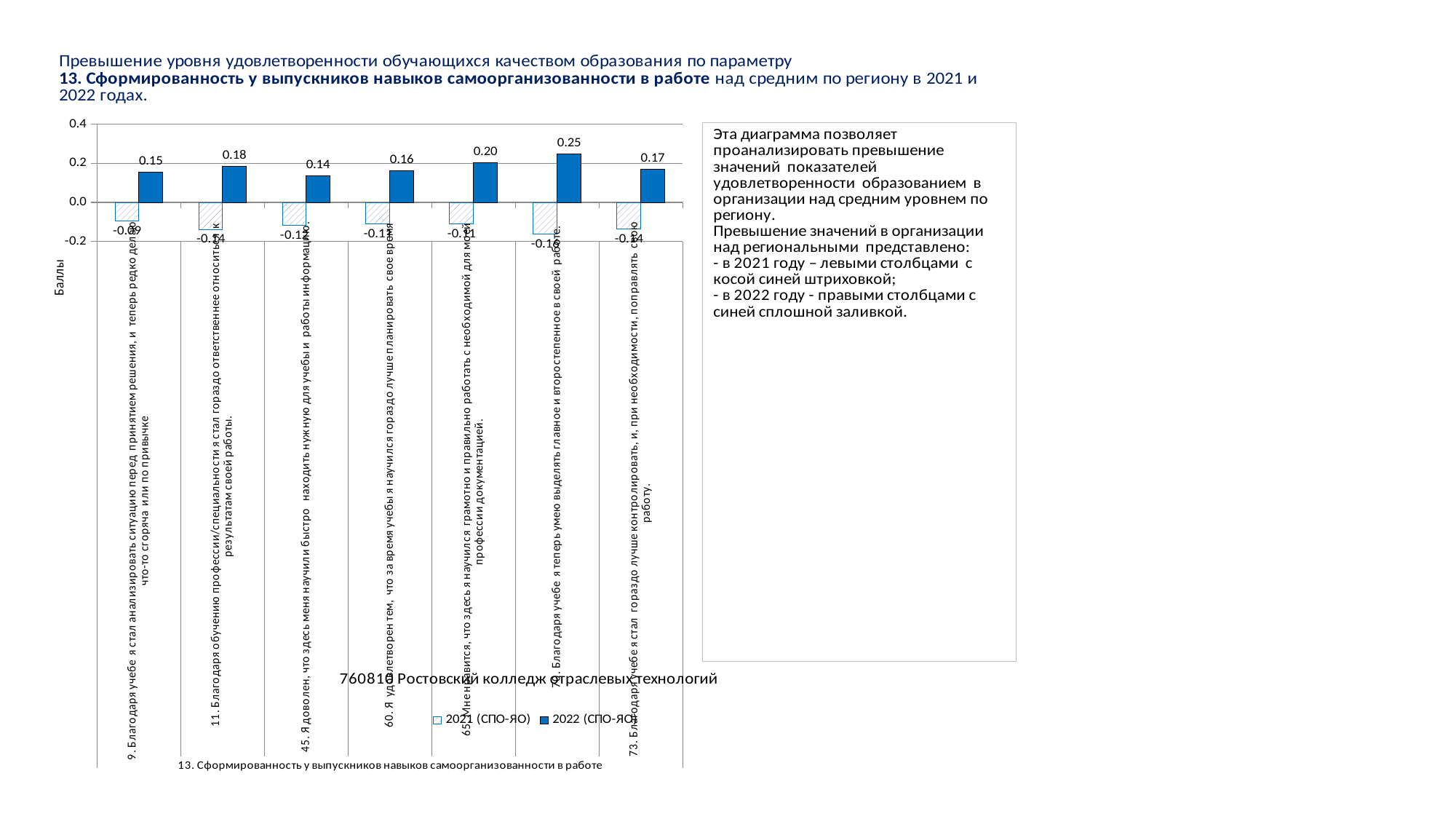
What kind of chart is shown on the slide? Bar chart What is the 2022 (СПО-ЯО) value for item 65 (Мне нравится, что здесь я научился грамотно и правильно работать с необходимой для моей профессии документацией)? 0.20 What is the title of the vertical axis of the chart? Баллы Which is larger: the 2022 (СПО-ЯО) value for item 11 or for item 60? Item 11 (0.18) Which category has the highest 2022 (СПО-ЯО) value? 70. Благодаря учебе я теперь умею выделять главное и второстепенное в своей работе How many categories (survey items) are shown on the chart? 7 How many series does the legend list? 2 Which category has the lowest 2022 (СПО-ЯО) value? 45. Я доволен, что здесь меня научили быстро находить нужную для учебы и работы информацию